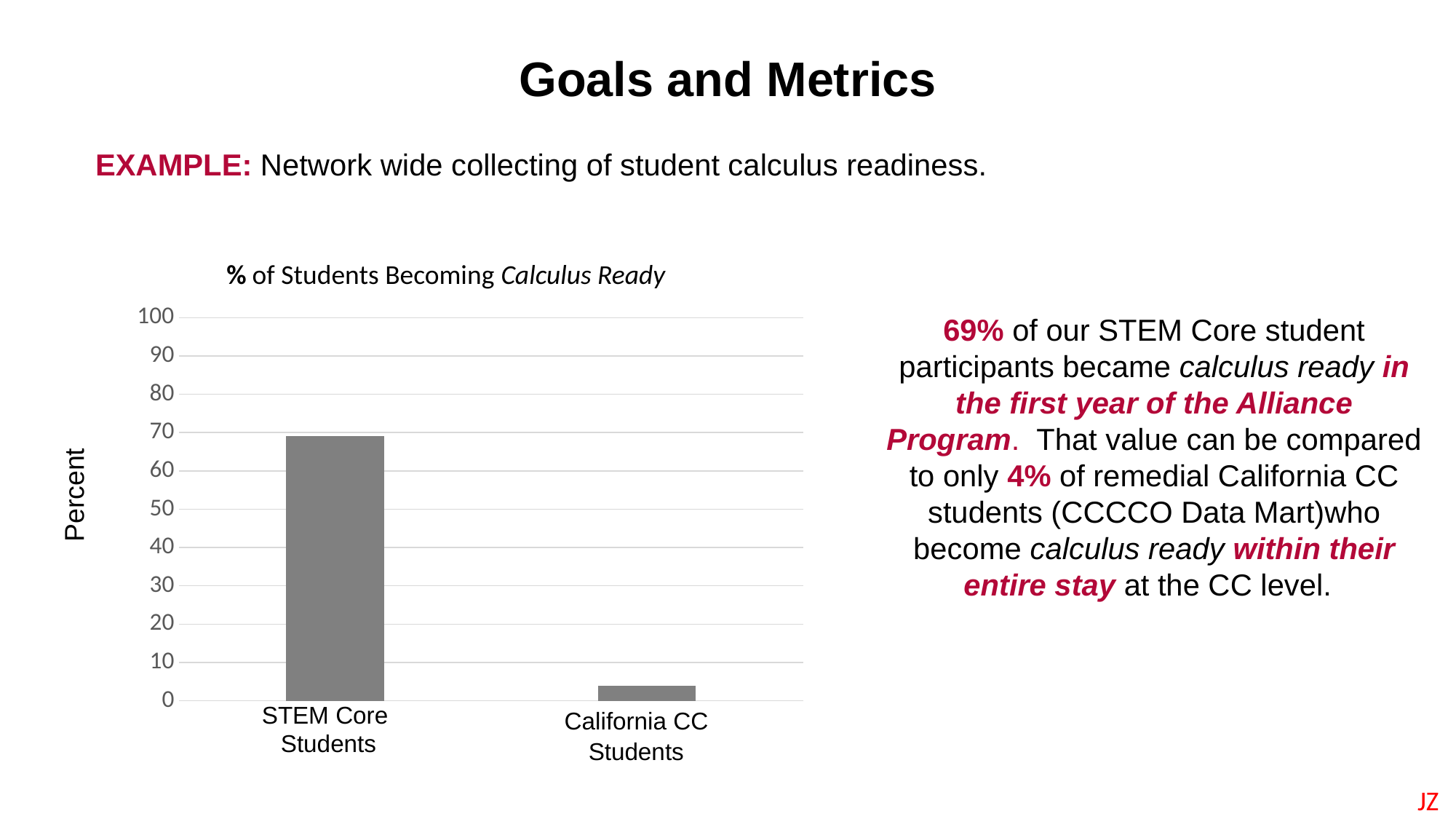
Which category has the lowest value in the chart? California CC Students Is the value for STEM Core Students greater or less than 60? greater Is the value for California CC Students greater or less than 10? less What is the label of the vertical axis of the chart? Percent Which is larger, the value for STEM Core Students or the value for California CC Students? STEM Core Students Which category has the highest value in the chart? STEM Core Students What is the title of the chart? % of Students Becoming Calculus Ready According to the slide, what percentage of remedial California CC students became calculus ready? 4% According to the slide, what percentage of STEM Core students became calculus ready? 69% How many categories are plotted in the chart? 2 What type of chart is shown on the slide? bar chart